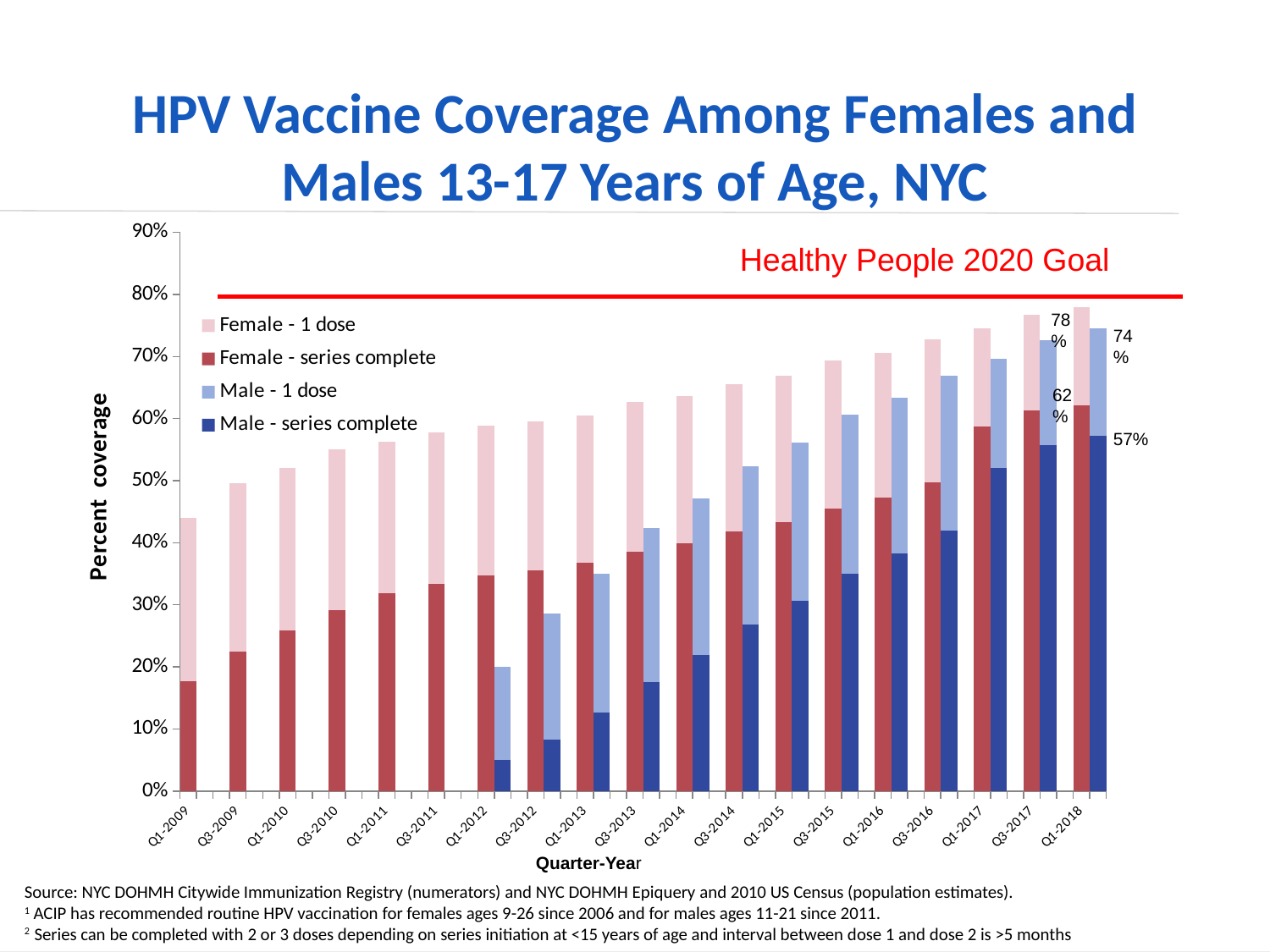
Is the Female - 1 dose value for Q1-2009 greater or less than 50%? less What is the Male - series complete coverage for Q1-2018? 57% What is the Female - series complete coverage for Q1-2018? 62% What is the Female - 1 dose coverage for Q1-2018? 78% At what percent coverage is the Healthy People 2020 Goal line drawn? 80% What kind of chart is shown on the slide? Bar chart In Q1-2018, which is larger: Female - series complete or Male - series complete coverage? Female - series complete What is the Male - 1 dose coverage for Q1-2018? 74% How many quarter-year labels are shown on the x axis? 19 In Q1-2018, how many percentage points higher is Female - 1 dose coverage than Male - 1 dose coverage? 4 How many series does the legend list? 4 Is the Male - series complete value for Q1-2012 greater or less than 10%? less